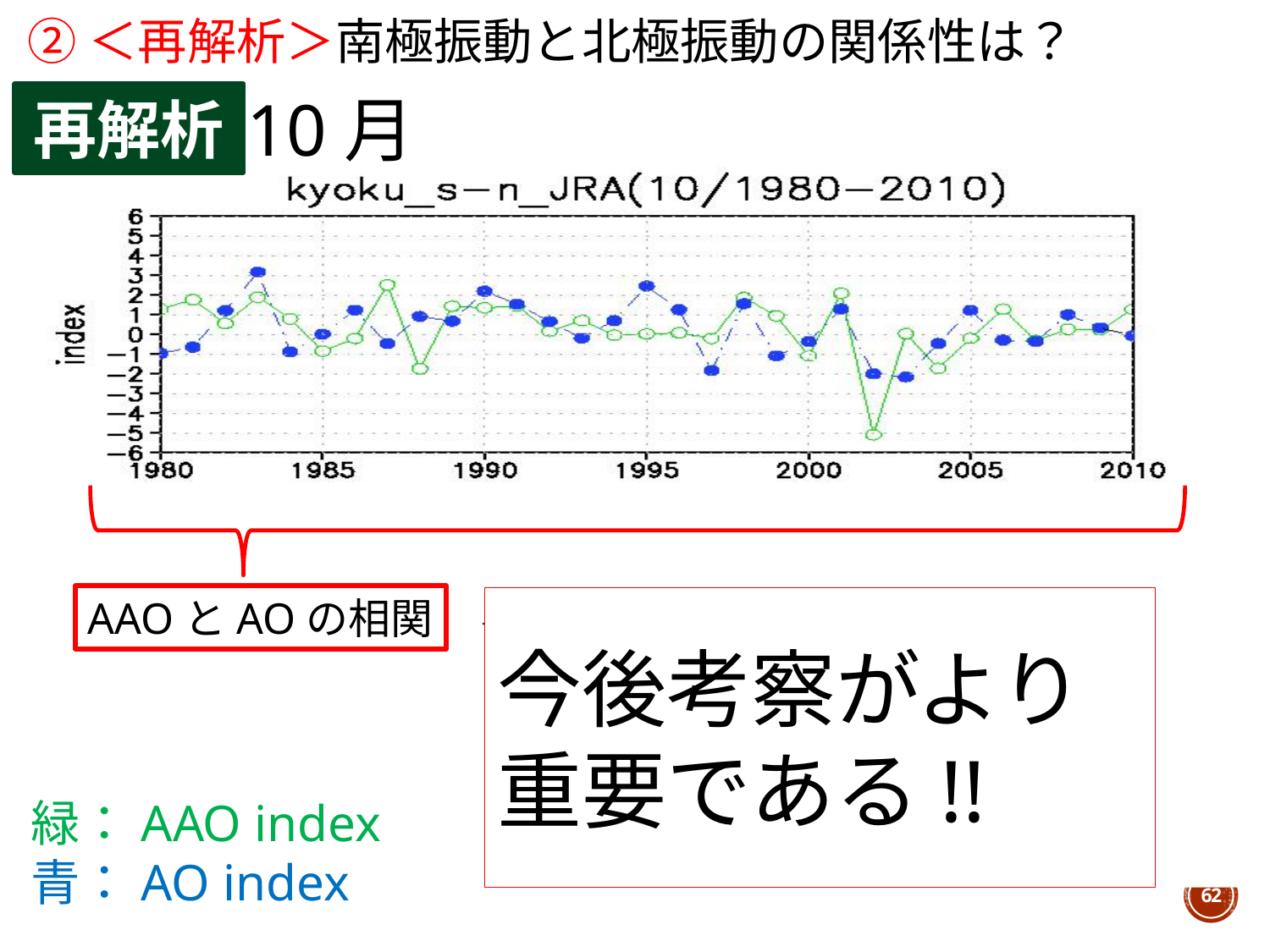
What kind of chart is shown on the slide? line chart How many series are plotted in the chart? 2 What is the label on the y axis of the chart? index Is the blue AO index value in 1983 greater or less than 2? greater Is the green AAO index value in 2002 greater or less than -4? less In which year does the green AAO index reach its highest value? 1987 In which year does the blue AO index reach its highest value? 1983 What is the title printed above the chart? kyoku_s-n_JRA(10/1980-2010) In 1983, which series has the higher value, the green AAO index or the blue AO index? AO index In which year does the green AAO index reach its lowest value? 2002 Which series is drawn in green according to the slide? AAO index In 2002, which series has the lower value, the green AAO index or the blue AO index? AAO index